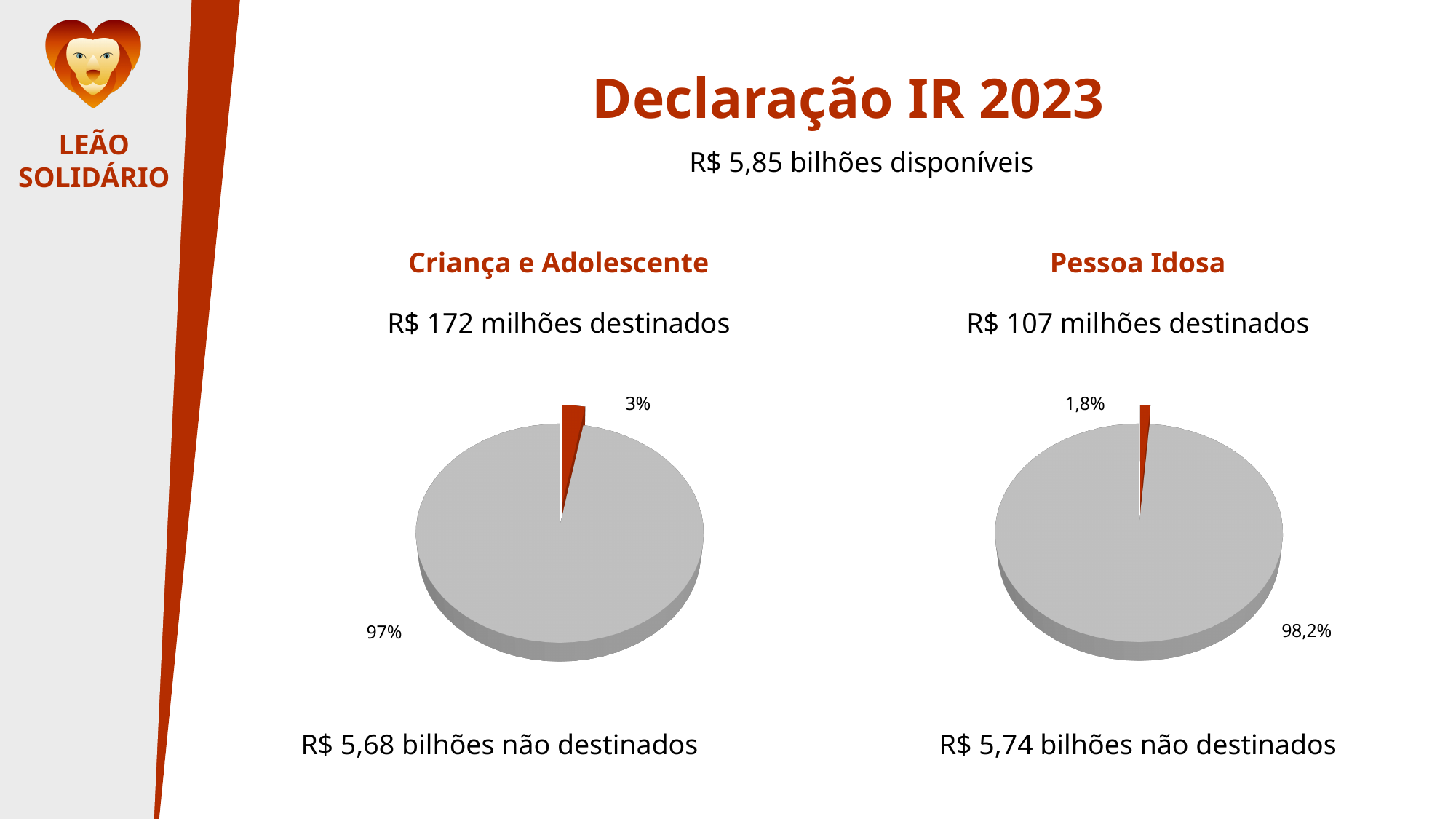
How many slices does the "Criança e Adolescente" pie chart have? 2 In the "Criança e Adolescente" pie chart, which slice is the largest? 97% In the "Criança e Adolescente" pie chart, what percentage is shown for the large grey slice? 97% In the "Pessoa Idosa" pie chart, what percentage is shown for the small red slice? 1,8% In the "Pessoa Idosa" pie chart, what percentage is shown for the large grey slice? 98,2% In the "Pessoa Idosa" pie chart, which slice is the smallest? 1,8% What kind of chart is shown under "Criança e Adolescente"? pie chart What is the difference between the grey slice percentages of the "Pessoa Idosa" and "Criança e Adolescente" pie charts? 1,2% How many slices does the "Pessoa Idosa" pie chart have? 2 What colour is the smaller slice in both pie charts? red Which red slice is larger: the one in the "Criança e Adolescente" pie chart or the one in the "Pessoa Idosa" pie chart? Criança e Adolescente